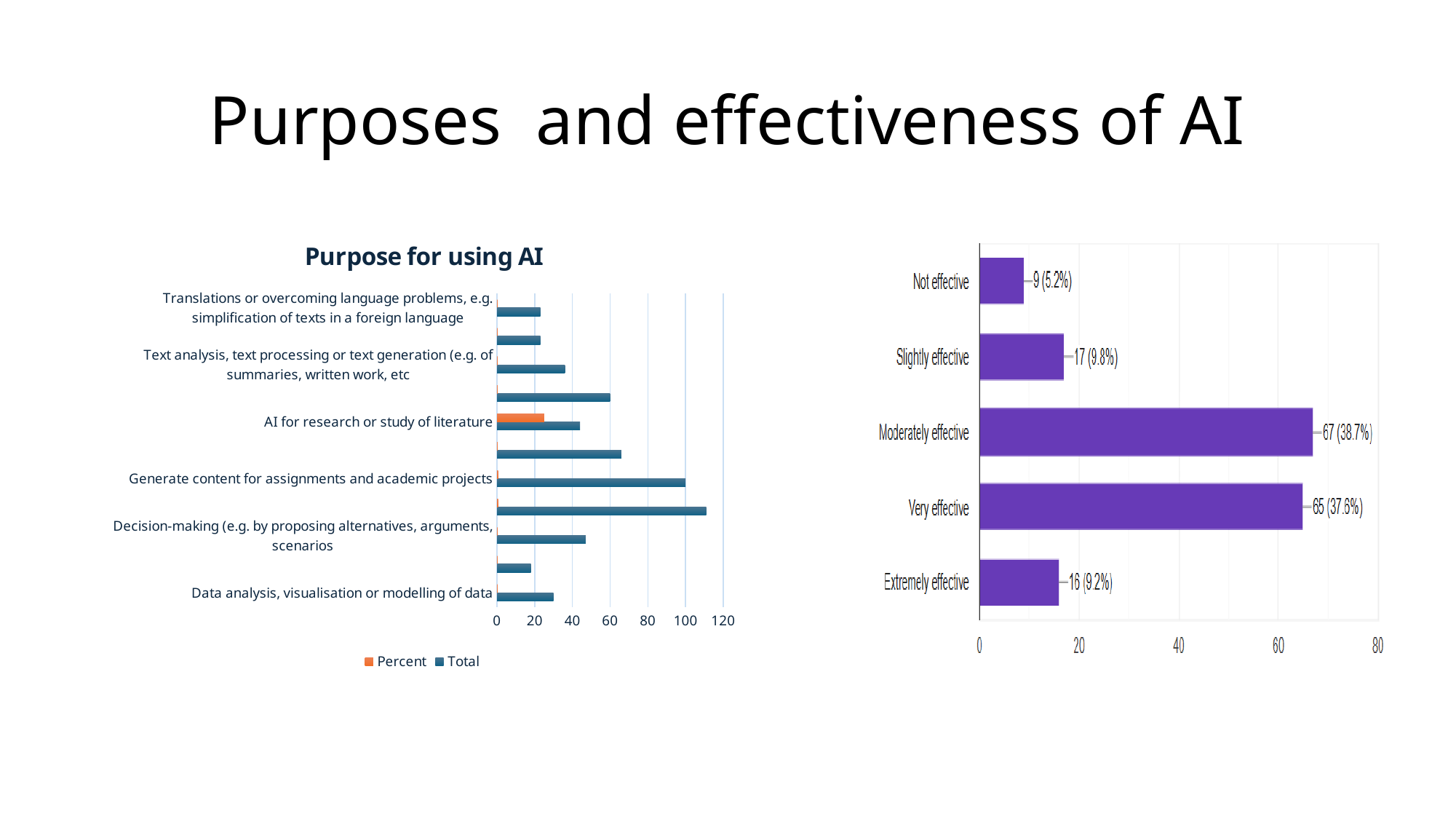
On the right-hand chart, which category has the highest value? Moderately effective On the right-hand chart, what is the difference between the counts for Slightly effective and Not effective? 8 On the 'Purpose for using AI' chart, is the Total value for 'Data analysis, visualisation or modelling of data' greater or less than 40? less On the right-hand chart, what is the value for Moderately effective? 67 (38.7%) What kind of chart is the 'Purpose for using AI' chart? Bar chart On the right-hand chart, what is the value for Not effective? 9 (5.2%) On the right-hand chart, which is larger: the count for Slightly effective or the count for Extremely effective? Slightly effective On the right-hand chart, which category has the lowest value? Not effective On the right-hand chart, what is the difference between the counts for Moderately effective and Very effective? 2 How many series does the legend of the 'Purpose for using AI' chart list? 2 How many categories are shown on the right-hand chart? 5 On the right-hand chart, what percentage is shown for Very effective? 37.6%